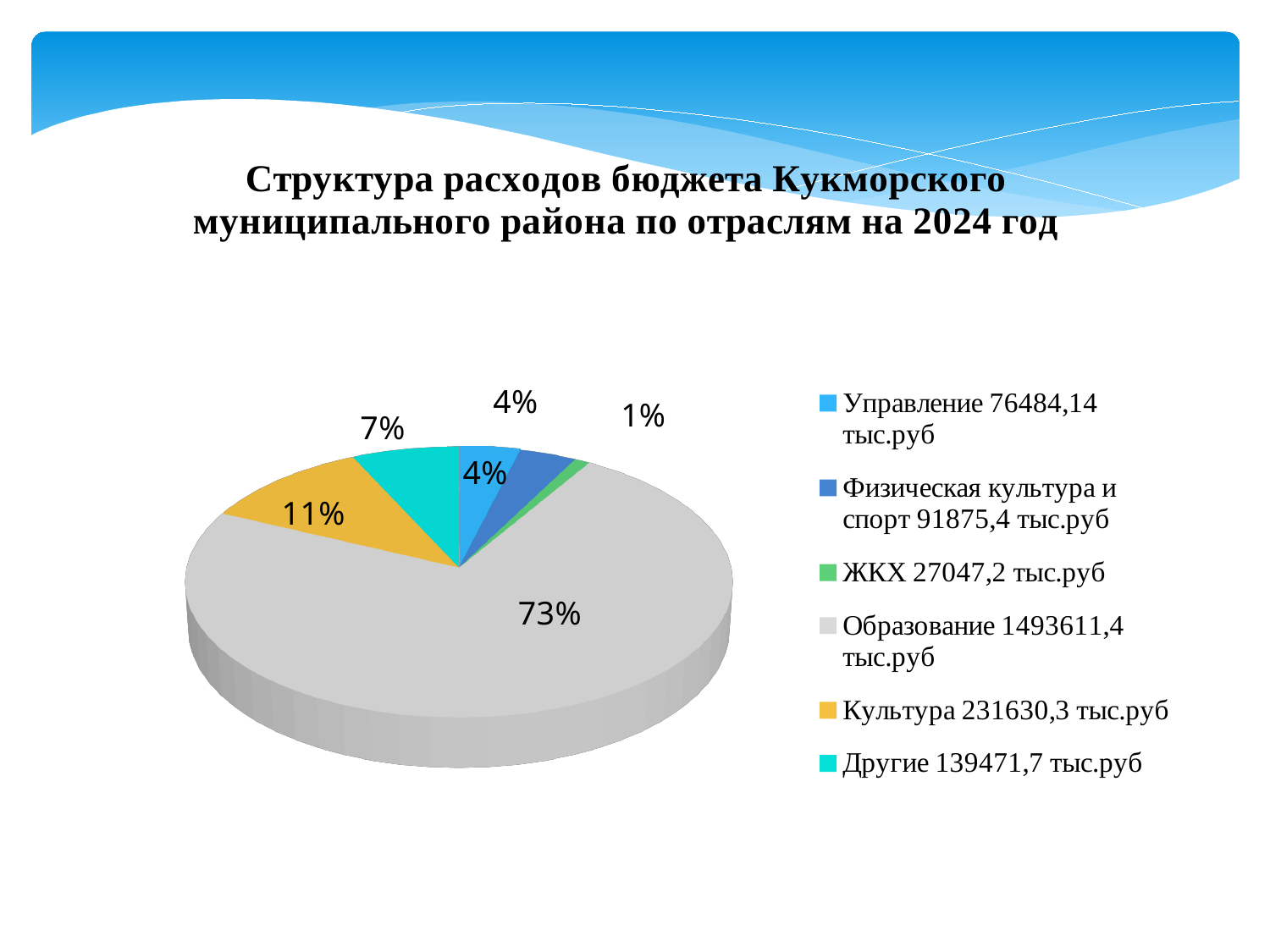
Which slice is larger, Культура or Другие? Культура What is the difference in percentage points between the Образование slice and the Культура slice? 62% According to the legend, what is the amount for Образование? 1493611,4 тыс.руб What share of the pie does Культура take? 11% What share of the pie does Другие take? 7% According to the legend, what is the amount for Культура? 231630,3 тыс.руб What share of the pie does Образование take? 73% What kind of chart is shown on the slide? pie chart Which category has the smallest slice of the pie? ЖКХ Which category has the largest slice of the pie? Образование How many categories does the pie chart show? 6